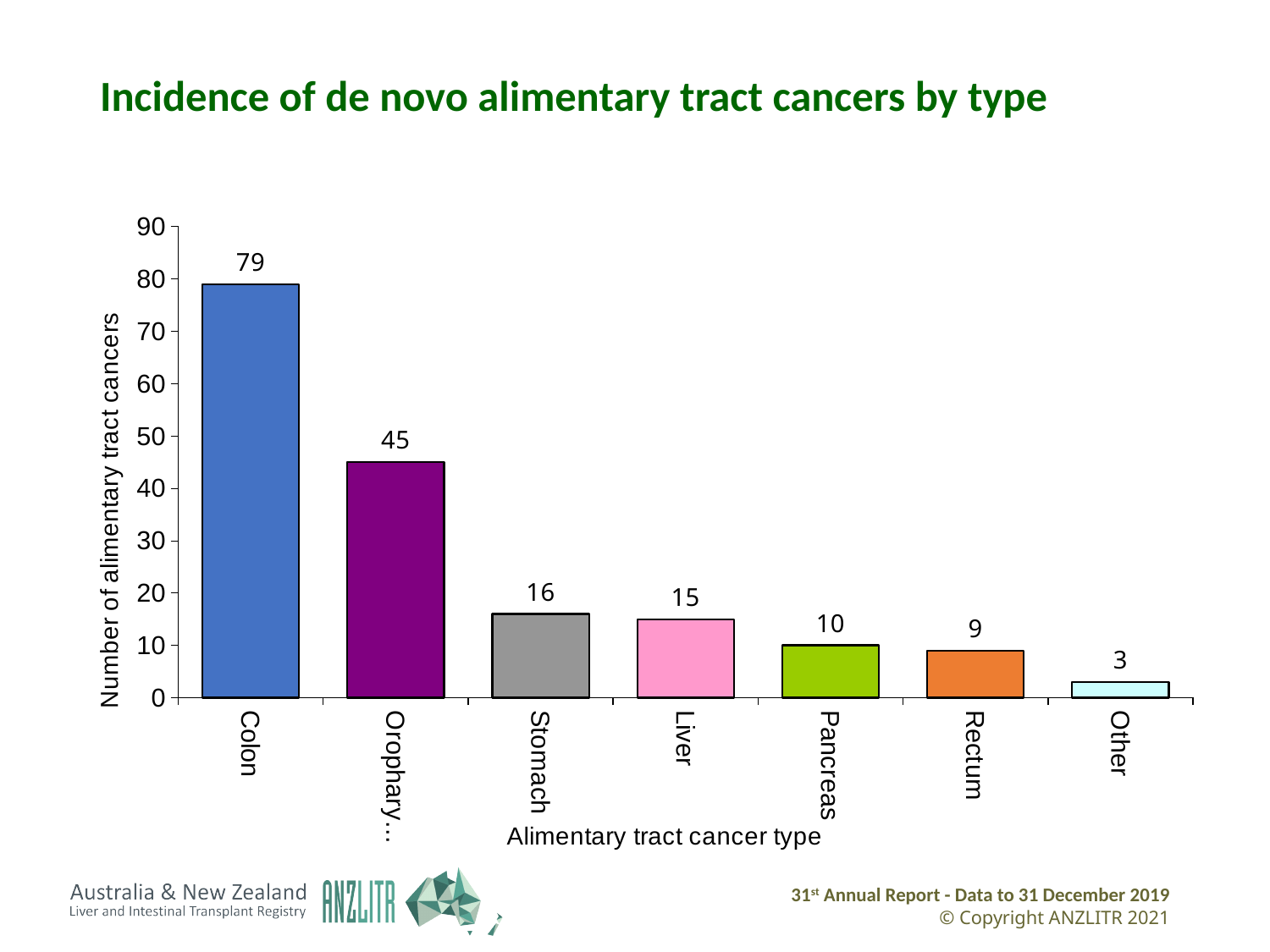
What is the number of alimentary tract cancers for Other? 3 What kind of chart is shown on the slide? Bar chart How many cancer type categories are shown on the x axis? 7 Which cancer type has the lowest number of alimentary tract cancers? Other What is the number of alimentary tract cancers for Pancreas? 10 What is the number of alimentary tract cancers for Stomach? 16 What is the number of alimentary tract cancers for Colon? 79 Which has more alimentary tract cancers, Liver or Pancreas? Liver What is the title of the chart? Incidence of de novo alimentary tract cancers by type What is the difference between the number of cancers for Colon and Stomach? 63 Which cancer type has the highest number of alimentary tract cancers? Colon What is the difference between the number of cancers for Liver and Rectum? 6